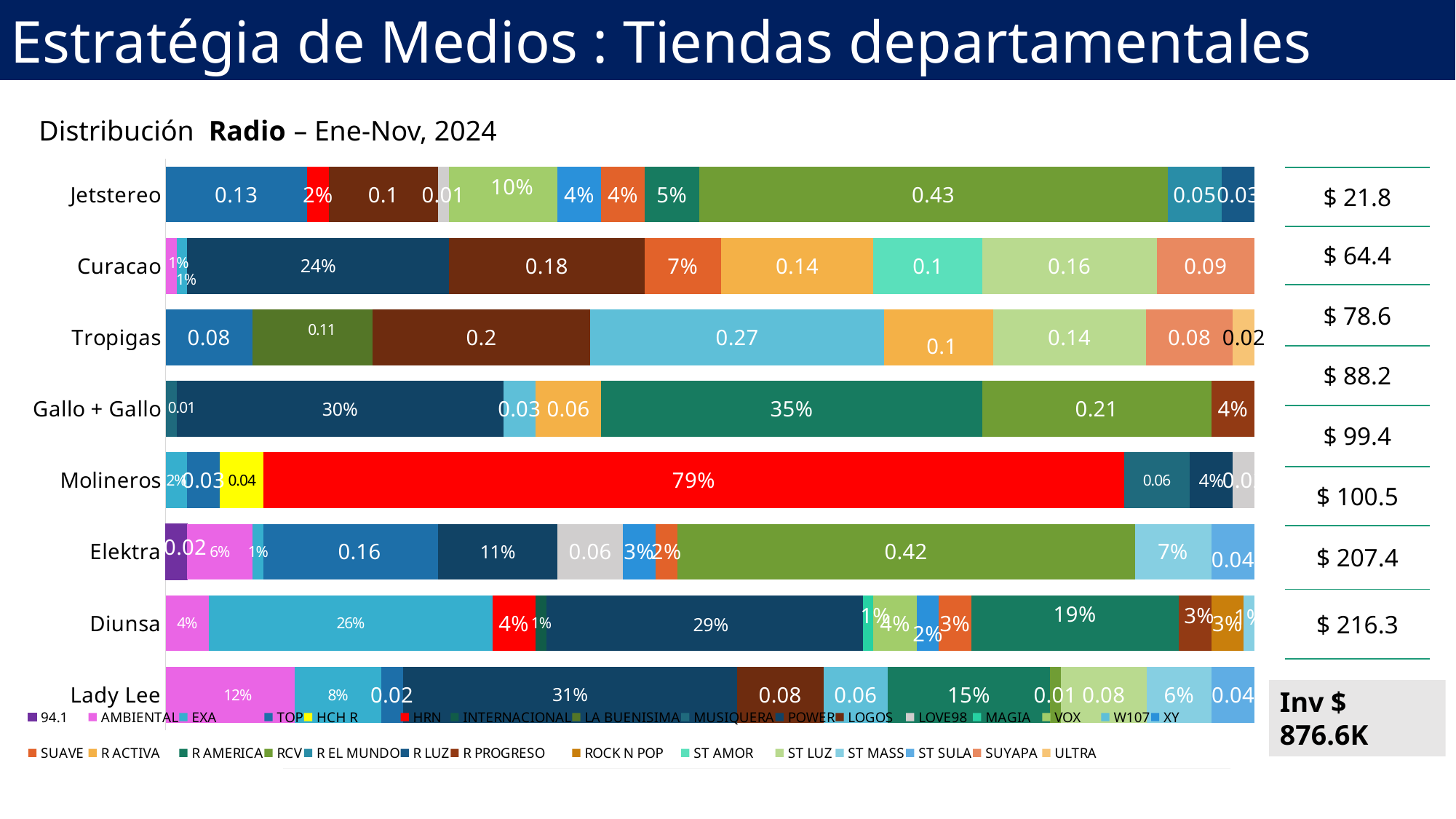
What is the title of the chart? Distribución Radio – Ene-Nov, 2024 What kind of chart is shown on the slide? stacked bar chart What is the largest labelled segment in the Tropigas bar? 0.27 How many series does the legend list? 30 What is the largest labelled segment in the Gallo + Gallo bar? 35% What is the largest labelled segment in the Molineros bar? 79% What is the largest labelled segment in the Jetstereo bar? 0.43 Which store has the single largest labelled segment in its bar, Molineros or Lady Lee? Molineros What is the largest labelled segment in the Diunsa bar? 29% What is the largest labelled segment in the Elektra bar? 0.42 What is the largest labelled segment in the Lady Lee bar? 31% How many store categories are plotted on the chart? 8